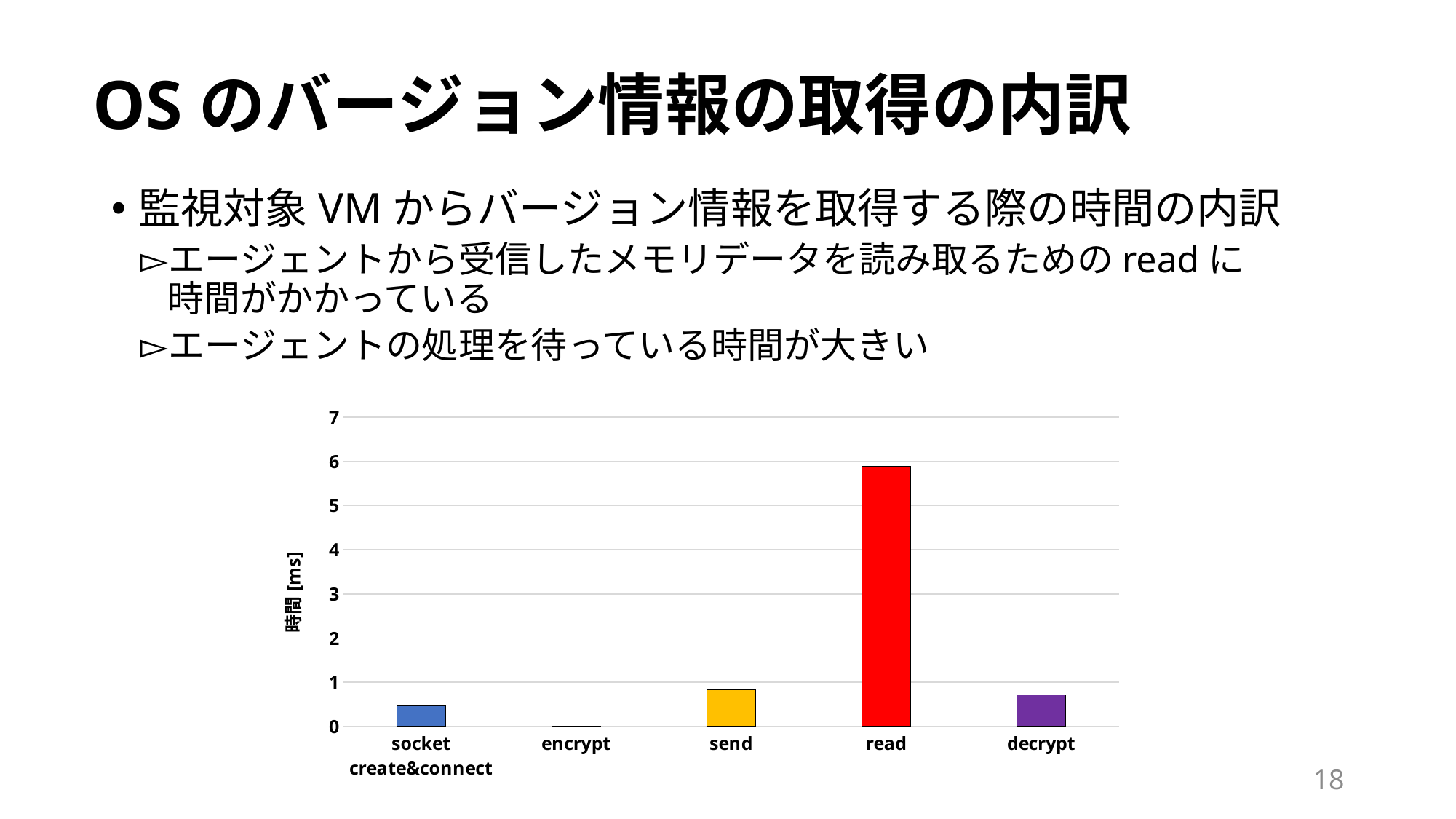
What is the highest tick value shown on the y axis of the chart? 7 Is the value for read greater or less than 6? less Is the value for send greater or less than 1? less Which category has the highest value in the chart? read Which is larger, the value for send or the value for socket create&connect? send Is the value for read greater or less than 5? greater How many categories are plotted on the x axis of the chart? 5 What is the label of the y axis of the chart? 時間 [ms] What kind of chart is shown on the slide? bar chart Which category has the lowest value in the chart? encrypt Which is larger, the value for read or the value for decrypt? read